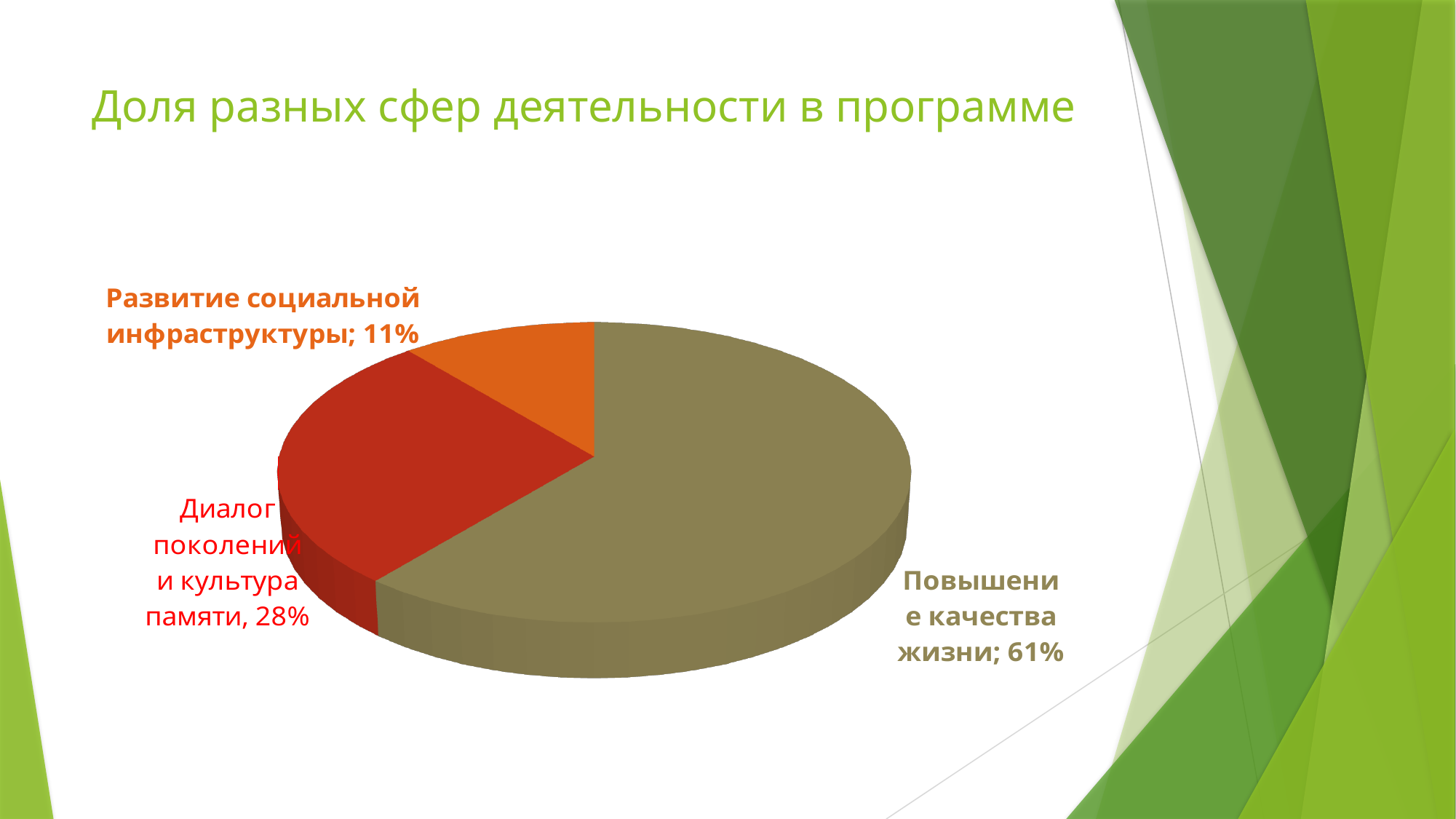
What share of the pie does "Диалог поколений и культура памяти" have? 28% Which is larger: the share for "Диалог поколений и культура памяти" or for "Развитие социальной инфраструктуры"? Диалог поколений и культура памяти What share of the pie does "Развитие социальной инфраструктуры" have? 11% What is the difference in percentage points between "Диалог поколений и культура памяти" and "Развитие социальной инфраструктуры"? 17 What is the title of the slide's chart? Доля разных сфер деятельности в программе What is the difference in percentage points between "Повышение качества жизни" and "Диалог поколений и культура памяти"? 33 Which category has the smallest slice of the pie? Развитие социальной инфраструктуры What share of the pie does "Повышение качества жизни" have? 61% What kind of chart is shown on the slide? Pie chart How many categories are shown in the pie chart? 3 Which category has the largest slice of the pie? Повышение качества жизни What colour is the slice for "Развитие социальной инфраструктуры"? Orange